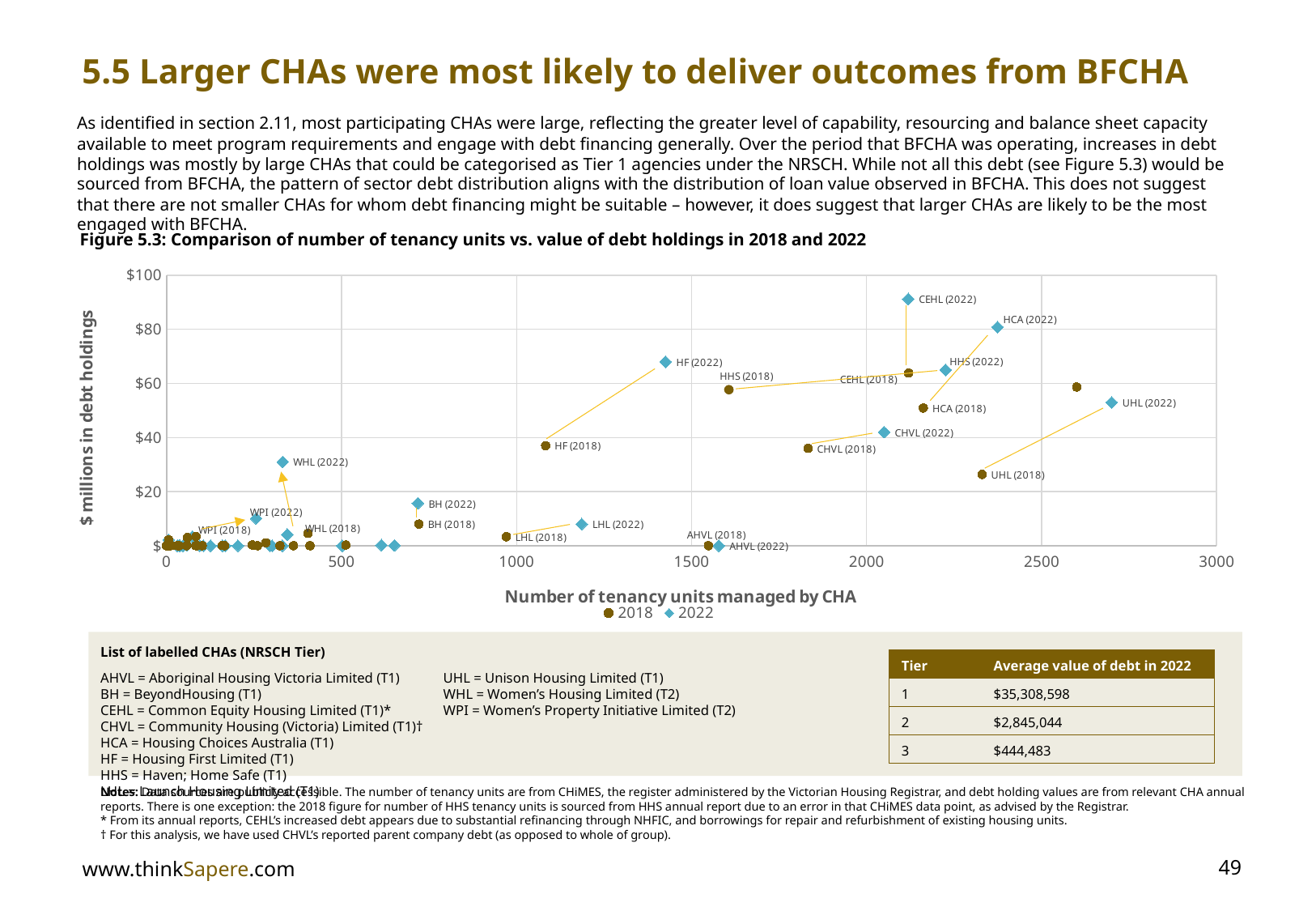
What are the two series named in the legend of Figure 5.3? 2018 and 2022 What is the title of the horizontal axis in Figure 5.3? Number of tenancy units managed by CHA In Figure 5.3, which has the larger value of debt holdings: HCA (2022) or HCA (2018)? HCA (2022) In Figure 5.3, is the number of tenancy units for UHL (2022) greater or less than 2500? greater How many series does the legend of Figure 5.3 list? 2 Which labelled point in Figure 5.3 has the highest value of debt holdings? CEHL (2022) In Figure 5.3, is the debt holdings value for HF (2022) greater or less than $60? greater In Figure 5.3, is the debt holdings value for LHL (2022) greater or less than $20? less What kind of chart is Figure 5.3? Scatter chart In Figure 5.3, did UHL's debt holdings rise or fall from 2018 to 2022? Rise In Figure 5.3, which has the larger value of debt holdings: CEHL (2022) or HHS (2022)? CEHL (2022)